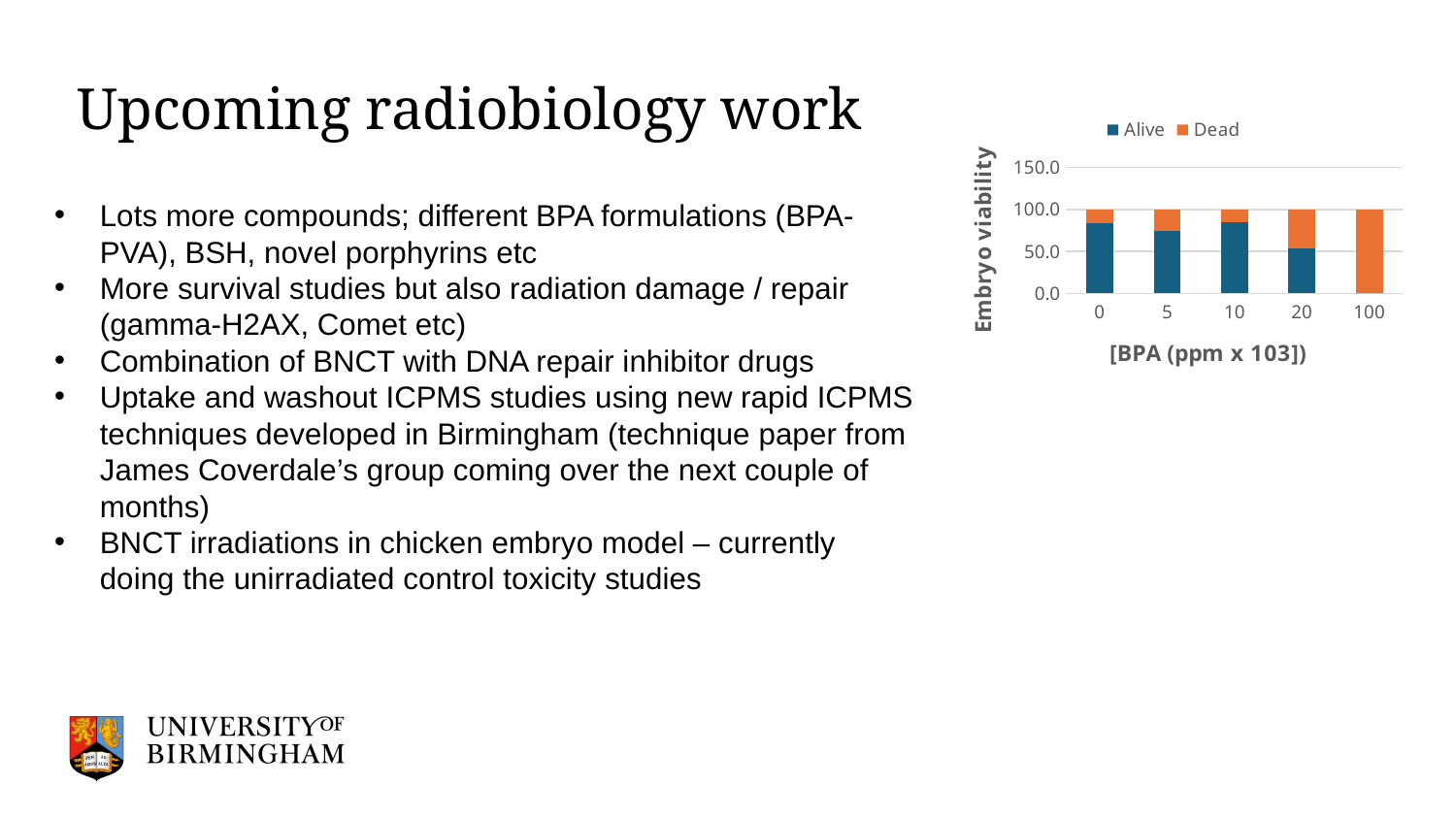
What is the label of the chart's vertical axis? Embryo viability What is the total height of the stacked bar at BPA concentration 100? 100.0 How many BPA concentration categories are plotted on the x axis? 5 Which BPA concentration has the highest Dead value? 100 Which BPA concentration has the lowest Alive value? 100 Is the Alive value at BPA concentration 0 greater or less than 50.0? greater How many series does the chart legend list? 2 What kind of chart is shown on the slide? stacked bar chart What are the two series named in the chart legend? Alive and Dead Which is larger, the Alive value at BPA concentration 0 or at BPA concentration 20? 0 Is the Alive value at BPA concentration 20 greater or less than 100.0? less Is the Dead value at BPA concentration 100 greater or less than 50.0? greater